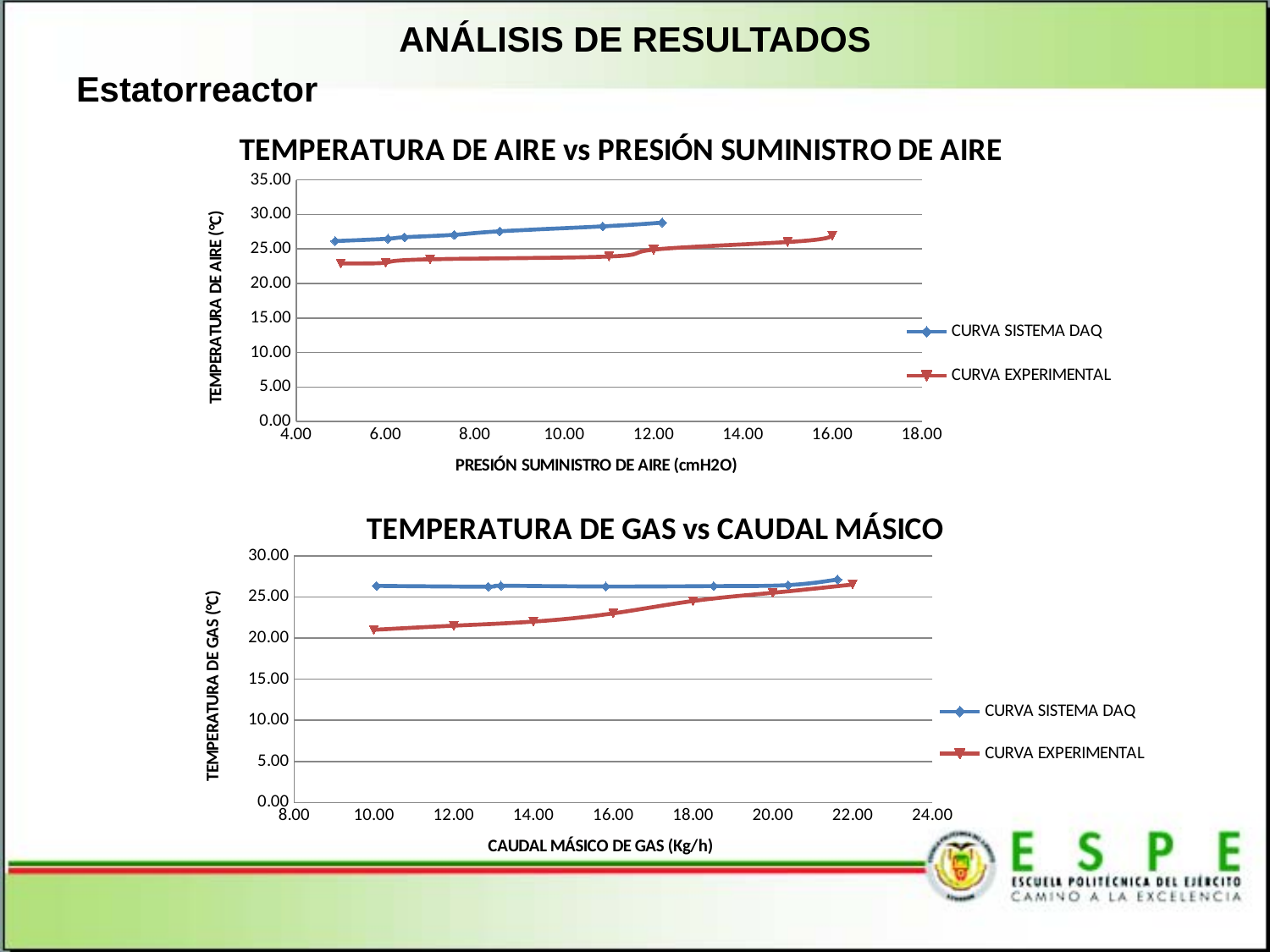
In the bottom chart, 'TEMPERATURA DE GAS vs CAUDAL MÁSICO', is the CURVA SISTEMA DAQ value at a mass flow of 10.00 Kg/h greater or less than 25.00? greater In the bottom chart, 'TEMPERATURA DE GAS vs CAUDAL MÁSICO', does the CURVA EXPERIMENTAL series rise or fall as the mass flow increases? Rise What is the x-axis label of the bottom chart, 'TEMPERATURA DE GAS vs CAUDAL MÁSICO'? CAUDAL MÁSICO DE GAS (Kg/h) In the bottom chart, 'TEMPERATURA DE GAS vs CAUDAL MÁSICO', is the CURVA EXPERIMENTAL value at a mass flow of 10.00 Kg/h greater or less than 25.00? less What kind of chart is the top chart, 'TEMPERATURA DE AIRE vs PRESIÓN SUMINISTRO DE AIRE'? Line chart In the top chart, 'TEMPERATURA DE AIRE vs PRESIÓN SUMINISTRO DE AIRE', which series has the higher temperature at a pressure of 6.00 cmH2O, CURVA SISTEMA DAQ or CURVA EXPERIMENTAL? CURVA SISTEMA DAQ In the top chart, 'TEMPERATURA DE AIRE vs PRESIÓN SUMINISTRO DE AIRE', does the CURVA EXPERIMENTAL series rise or fall as the pressure increases? Rise In the top chart, 'TEMPERATURA DE AIRE vs PRESIÓN SUMINISTRO DE AIRE', is the CURVA SISTEMA DAQ value at a pressure of 12.00 cmH2O greater or less than 25.00? greater How many series does the legend of the bottom chart, 'TEMPERATURA DE GAS vs CAUDAL MÁSICO', list? 2 In the bottom chart, 'TEMPERATURA DE GAS vs CAUDAL MÁSICO', which series has the higher temperature at a mass flow of 14.00 Kg/h, CURVA SISTEMA DAQ or CURVA EXPERIMENTAL? CURVA SISTEMA DAQ In the top chart, 'TEMPERATURA DE AIRE vs PRESIÓN SUMINISTRO DE AIRE', which colour is used for the CURVA EXPERIMENTAL series? Red